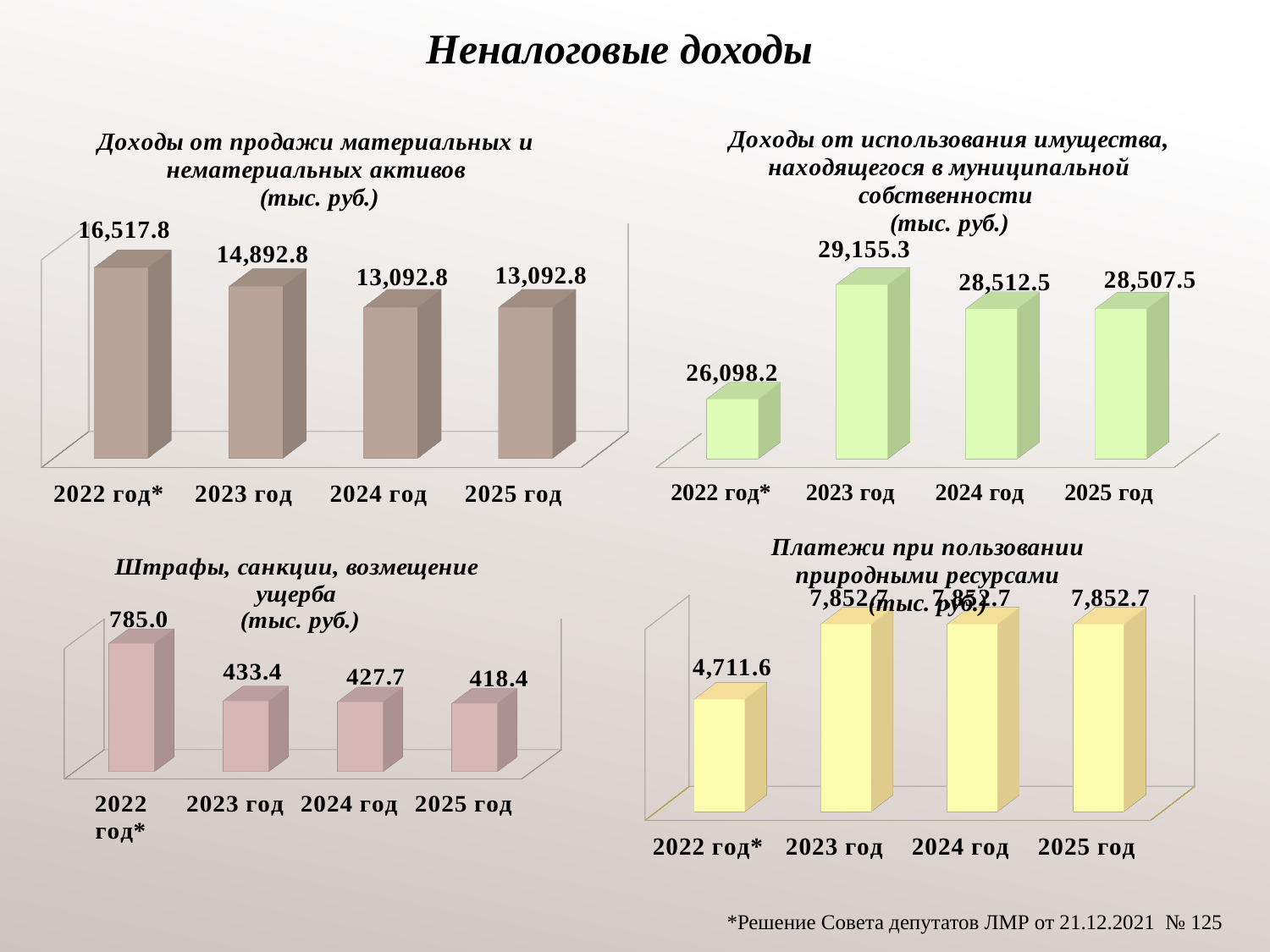
In the top-right chart (Доходы от использования имущества), what is the value for 2023 год? 29,155.3 In the top-left chart (Доходы от продажи материальных и нематериальных активов), what is the difference between the values for 2022 год* and 2023 год? 1,625.0 In the top-left chart (Доходы от продажи материальных и нематериальных активов), which year has the highest value? 2022 год* What type of chart is the top-left chart (Доходы от продажи материальных и нематериальных активов)? bar chart In the top-right chart (Доходы от использования имущества), which is larger: the value for 2023 год or 2024 год? 2023 год In the bottom-left chart (Штрафы, санкции, возмещение ущерба), what is the difference between the values for 2022 год* and 2023 год? 351.6 In the bottom-left chart (Штрафы, санкции, возмещение ущерба), what is the value for 2025 год? 418.4 In the top-left chart (Доходы от продажи материальных и нематериальных активов), what is the value for 2022 год*? 16,517.8 How many years (categories) are shown in the bottom-right chart (Платежи при пользовании природными ресурсами)? 4 In the bottom-left chart (Штрафы, санкции, возмещение ущерба), do the values rise or fall from 2022 to 2025? fall In the top-right chart (Доходы от использования имущества), which year has the lowest value? 2022 год* In the bottom-right chart (Платежи при пользовании природными ресурсами), what is the value for 2022 год*? 4,711.6